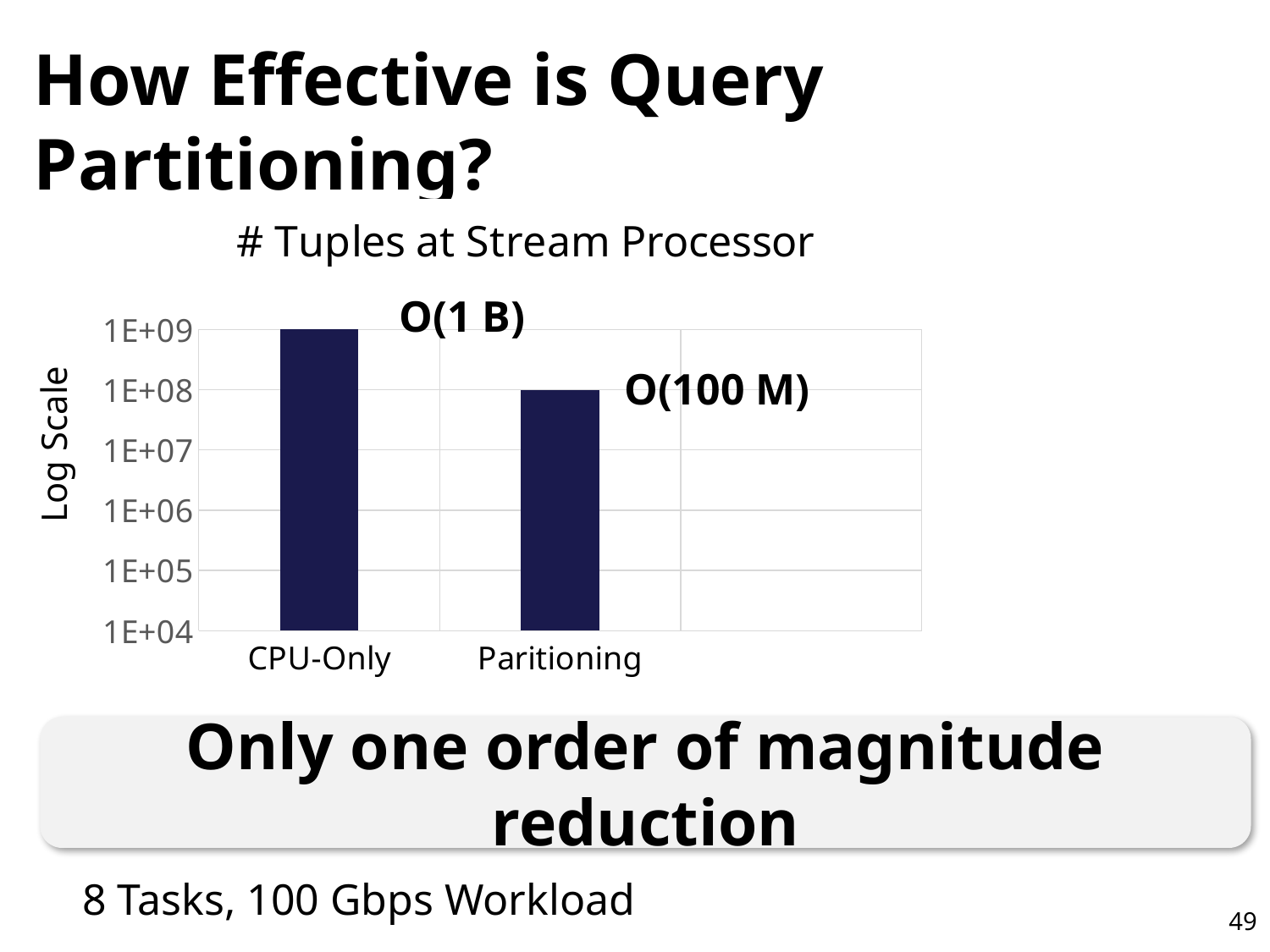
Which category has the lowest number of tuples at the stream processor? Paritioning What is the label on the vertical axis of the chart? Log Scale What is the title of the chart? # Tuples at Stream Processor What value does the CPU-Only bar reach on the vertical axis? 1E+09 How many bars (categories) are plotted in the chart? 2 What order-of-magnitude annotation is printed next to the Paritioning bar? O(100 M) What kind of chart is shown on the slide? bar chart Which category has the highest number of tuples at the stream processor? CPU-Only What order-of-magnitude annotation is printed next to the CPU-Only bar? O(1 B) What value does the Paritioning bar reach on the vertical axis? 1E+08 Do the values rise or fall from CPU-Only to Paritioning along the x axis? fall Which is larger, the value for CPU-Only or the value for Paritioning? CPU-Only